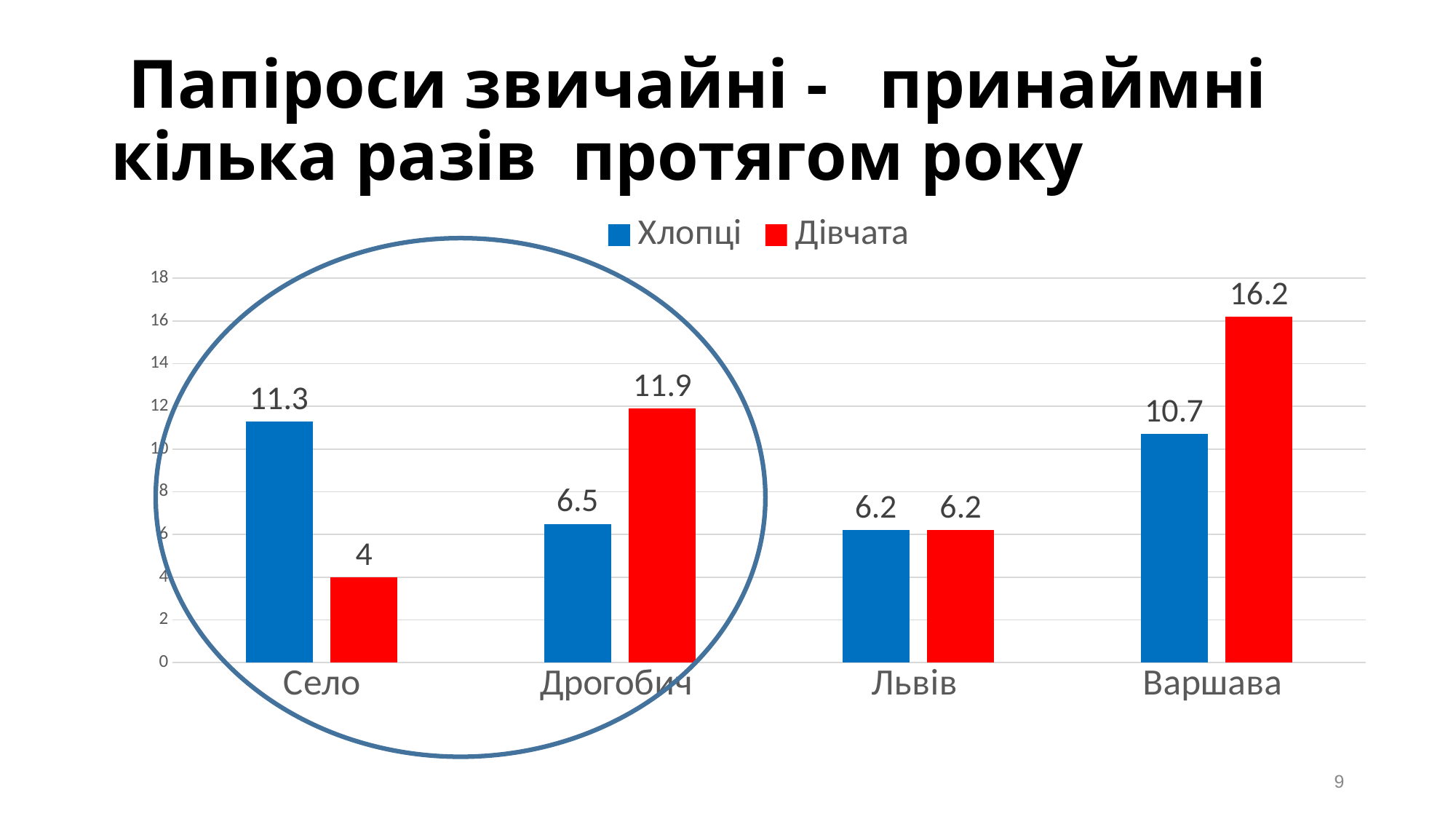
Which category has the highest value for Дівчата? Варшава What is the value for Хлопці in Село? 11.3 Which category has the lowest value for Дівчата? Село Which is larger in Село: the value for Хлопці or for Дівчата? Хлопці What is the value for Дівчата in Варшава? 16.2 How many categories are shown on the x axis? 4 How many series does the legend list? 2 What is the value for Дівчата in Дрогобич? 11.9 Which colour represents the Дівчата series? Red What is the difference between the Дівчата and Хлопці values in Варшава? 5.5 What kind of chart is shown on the slide? Bar chart Which category has the lowest value for Хлопці? Львів